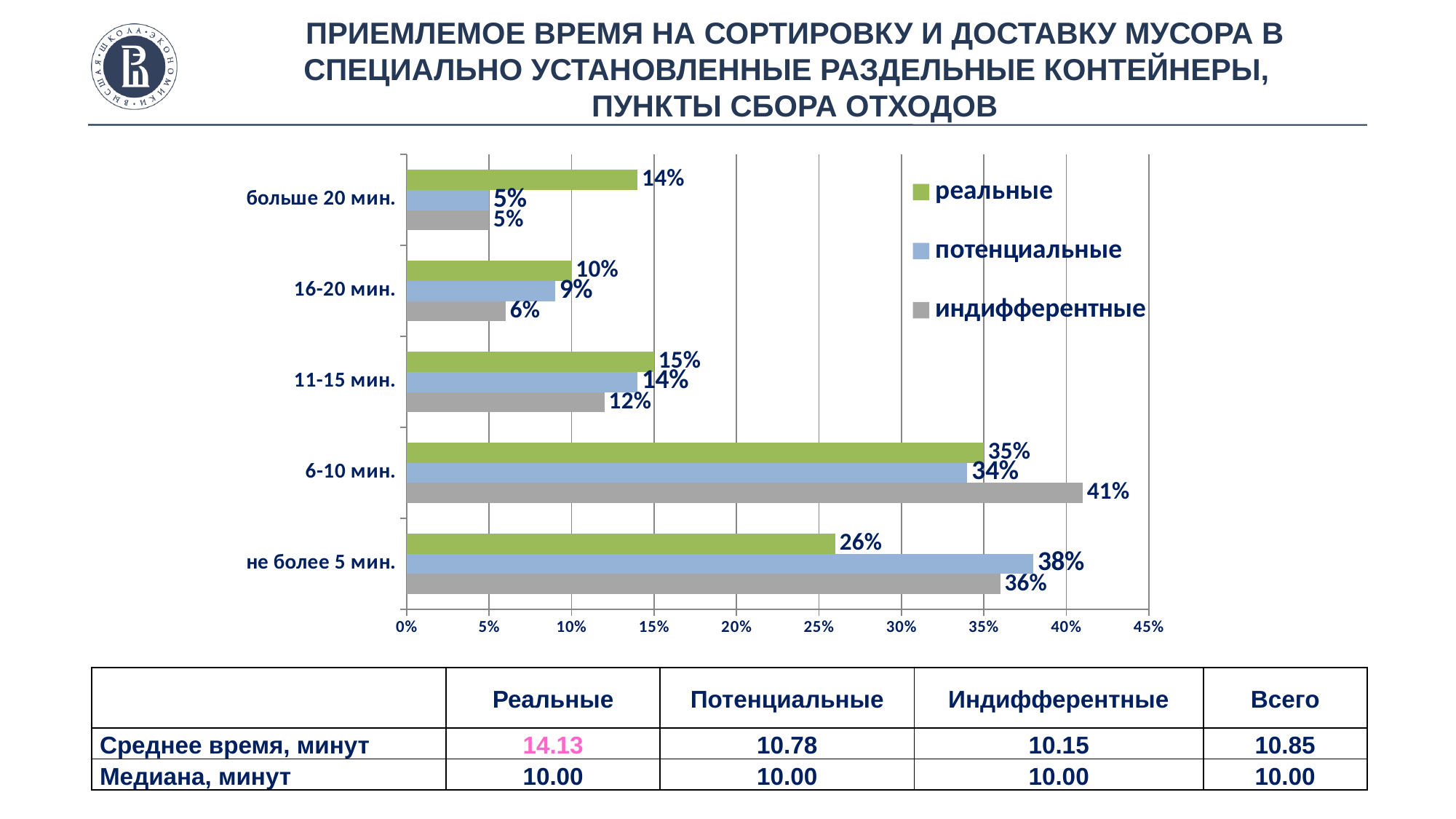
What is the value for "потенциальные" in the "не более 5 мин." category? 38% What kind of chart is shown on the slide? bar chart Which category has the highest value for the "индифферентные" series? 6-10 мин. Is the value for "реальные" in the "не более 5 мин." category greater or less than 25%? greater Which category has the lowest value for the "потенциальные" series? больше 20 мин. In the "не более 5 мин." category, which is larger: "реальные" or "потенциальные"? потенциальные How many series does the legend list? 3 Which colour represents the "потенциальные" series in the chart? blue How many time categories are shown on the chart? 5 What is the value for "реальные" in the "6-10 мин." category? 35% What is the difference between the "индифферентные" and "реальные" values in the "6-10 мин." category? 6% What is the value for "индифферентные" in the "16-20 мин." category? 6%